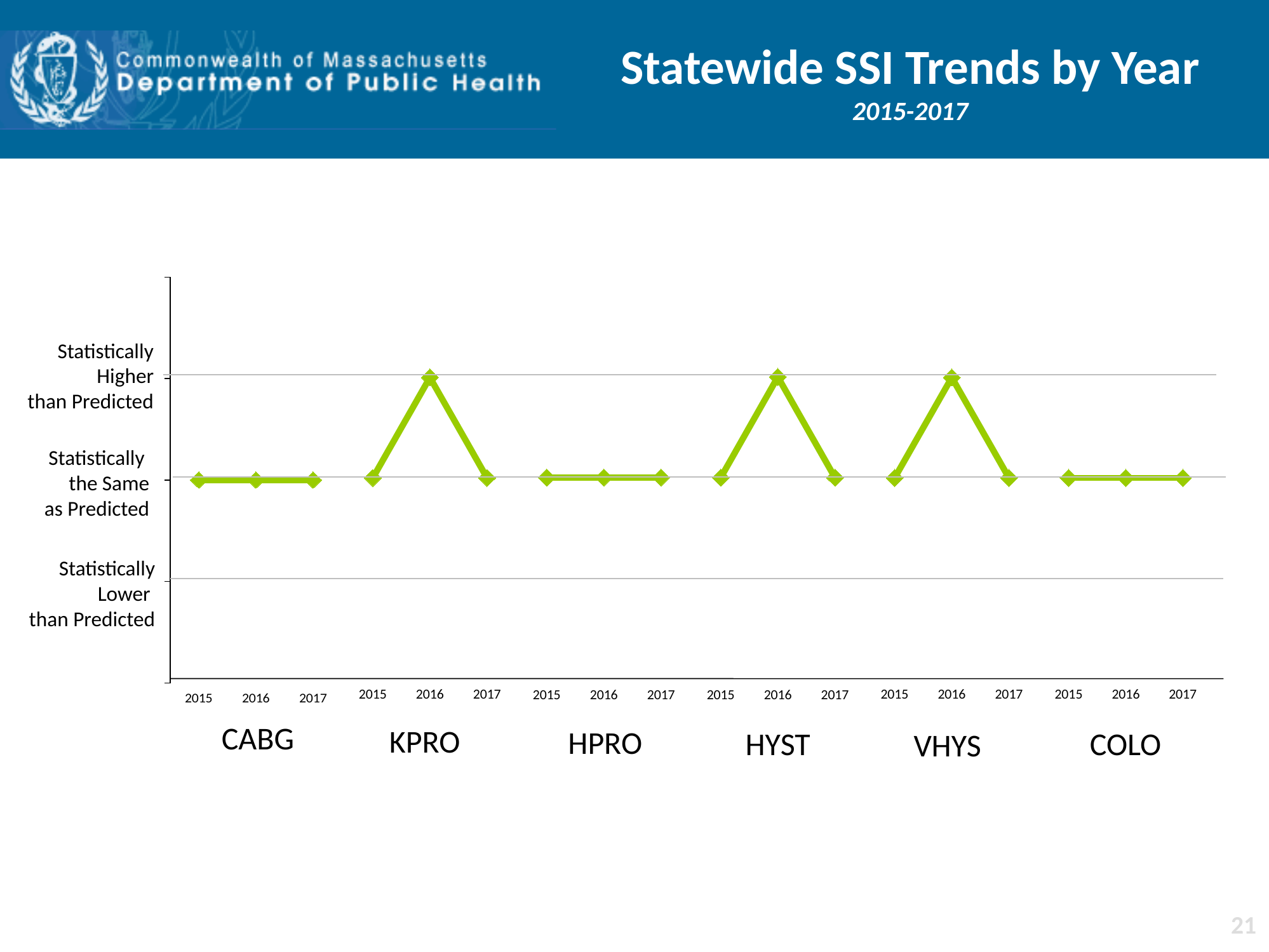
How many procedure groups are shown along the x axis of the chart? 6 What is the SSI status for KPRO in 2016? Statistically Higher than Predicted Which procedure groups reach the 'Statistically Higher than Predicted' level in any year? KPRO, HYST, VHYS How many data points are plotted in the chart in total? 18 What kind of chart is shown on the slide? line chart What is the title of the chart on the slide? Statewide SSI Trends by Year What is the SSI status for HYST in 2016? Statistically Higher than Predicted Which is higher, the SSI status for VHYS in 2016 or for COLO in 2016? VHYS in 2016 What is the SSI status for VHYS in 2015? Statistically the Same as Predicted For KPRO, does the SSI status rise or fall from 2016 to 2017? fall Do any procedure groups fall to the 'Statistically Lower than Predicted' level in any year? No What is the SSI status for CABG in 2017? Statistically the Same as Predicted